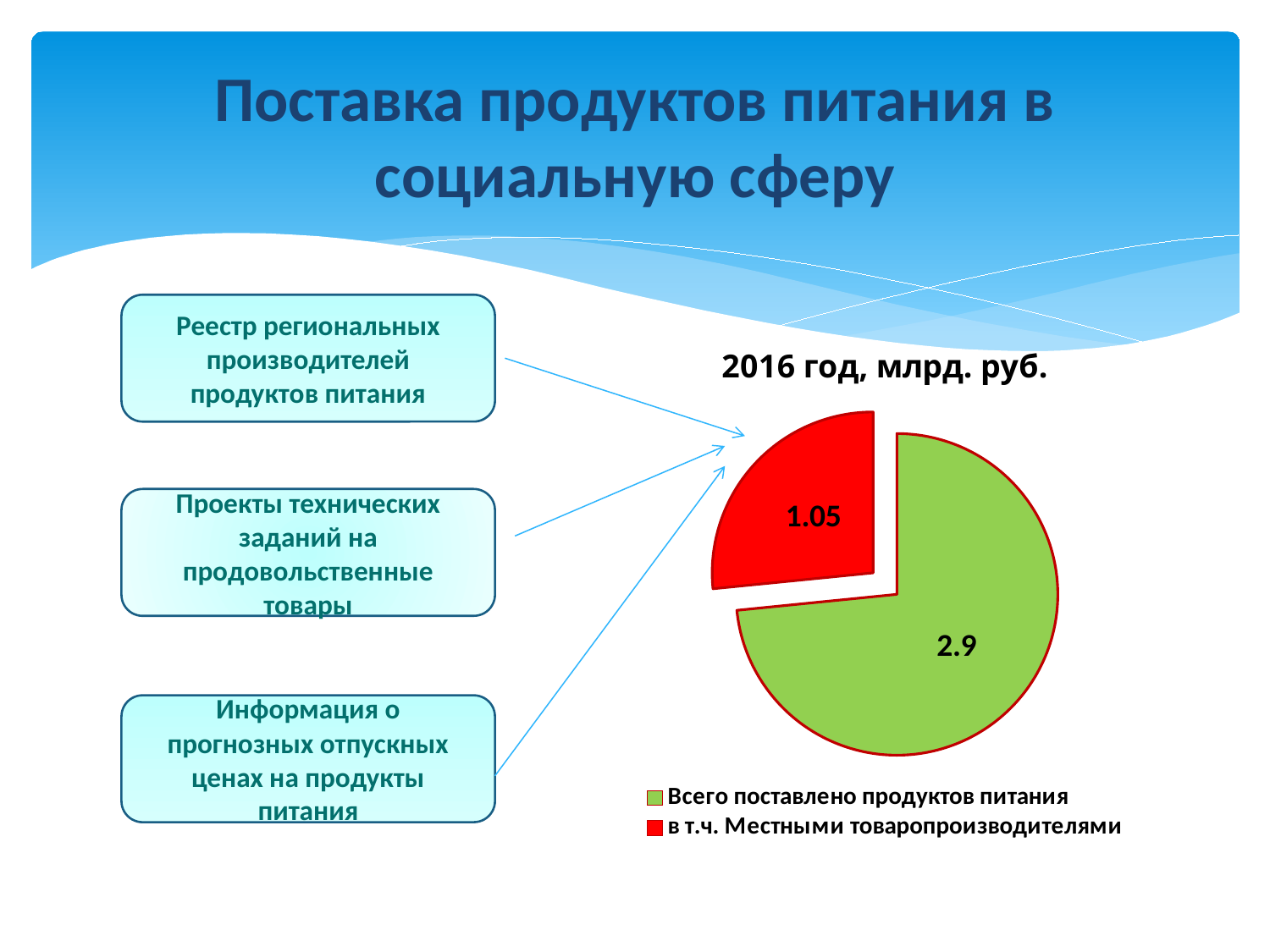
What kind of chart is shown on the slide? pie chart What is the value for "Всего поставлено продуктов питания" in the pie chart? 2.9 Which slice of the pie chart is the smallest? в т.ч. Местными товаропроизводителями What is the value for "в т.ч. Местными товаропроизводителями" in the pie chart? 1.05 Which slice of the pie chart is the largest? Всего поставлено продуктов питания What is the title of the pie chart? 2016 год, млрд. руб. What is the difference between the values of the two slices in the pie chart? 1.85 What colour is the slice for "в т.ч. Местными товаропроизводителями" in the pie chart? red What is the sum of the two values shown in the pie chart? 3.95 Which is larger in the pie chart: "Всего поставлено продуктов питания" or "в т.ч. Местными товаропроизводителями"? Всего поставлено продуктов питания How many entries does the legend of the pie chart list? 2 How many slices does the pie chart have? 2